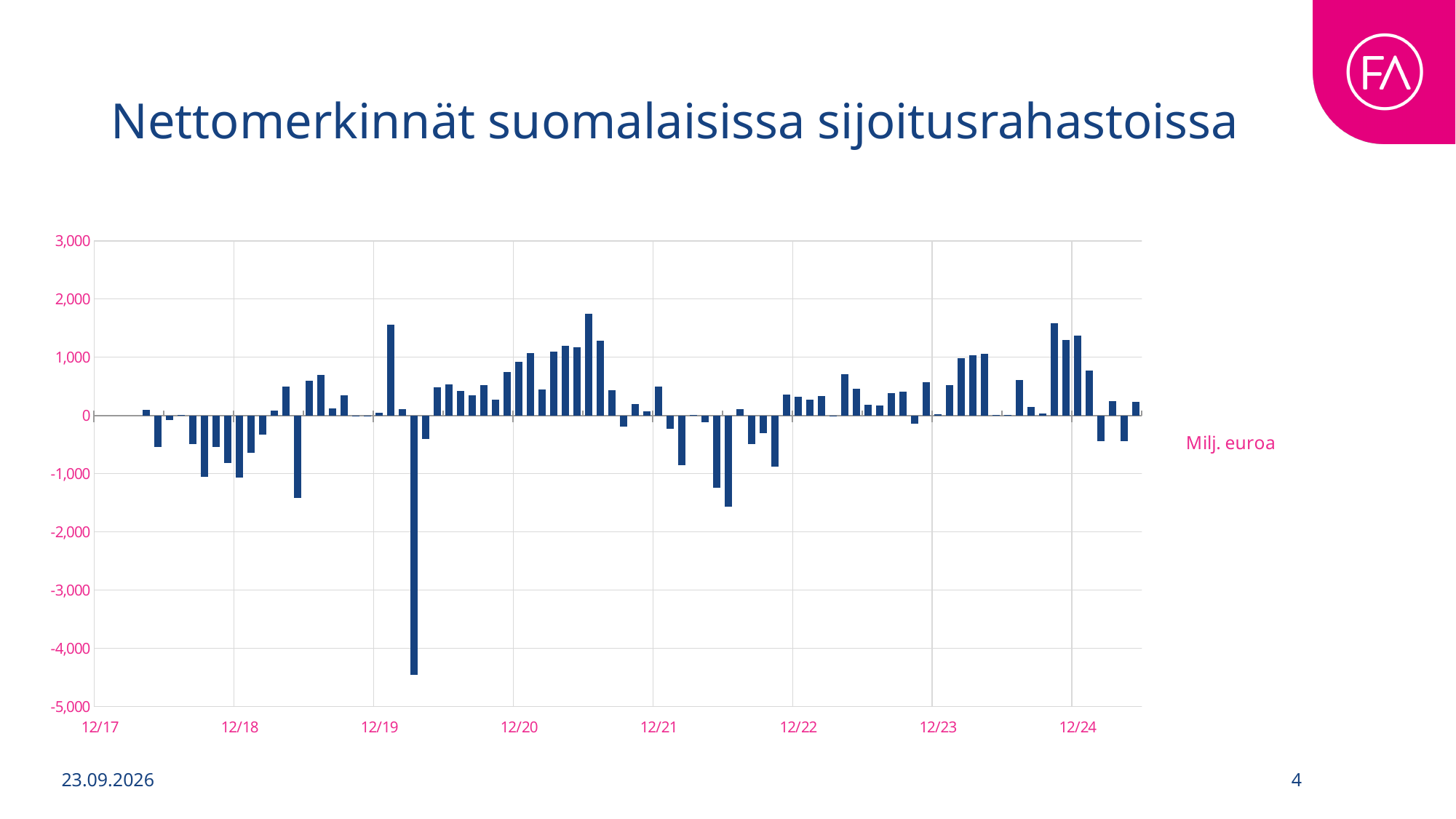
What is the title of the chart? Nettomerkinnät suomalaisissa sijoitusrahastoissa What kind of chart is shown on the slide? bar chart Is the value at 12/24 greater or less than 1,000? greater Is the value at 12/21 greater or less than -1,000? greater Is the value at 12/18 greater or less than -500? less What unit is indicated next to the chart? Milj. euroa Which is larger, the value at 12/24 or the value at 12/18? 12/24 How many labels are shown on the x axis of the chart? 8